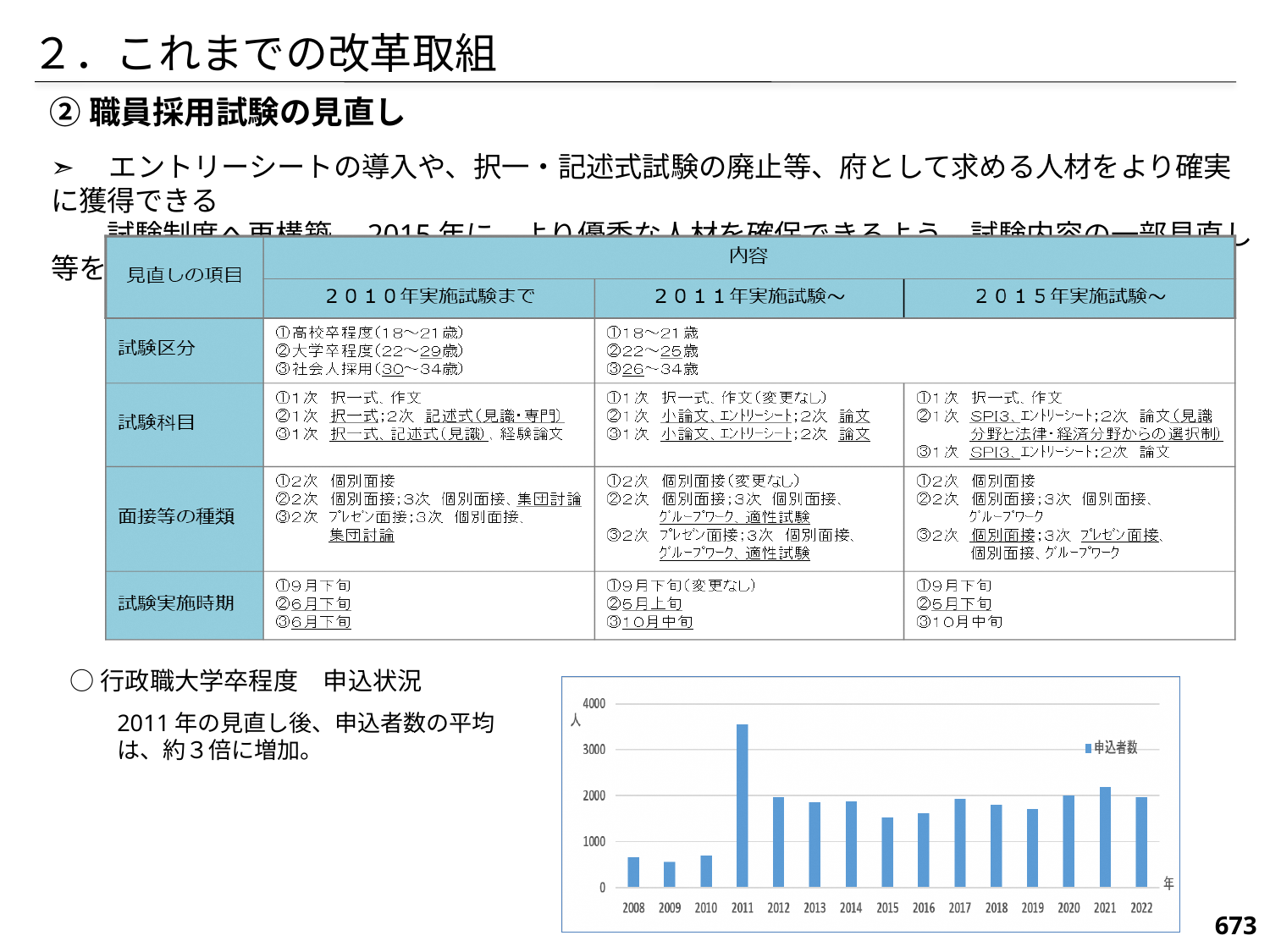
How many years are plotted on the x axis of the bar chart? 15 Is the value for 2011 greater or less than 3000? greater What kind of chart is shown at the bottom right of the slide? bar chart Which year has the larger value, 2010 or 2011? 2011 Is the value for 2015 greater or less than 2000? less Do the values rise or fall from 2008 to 2011 in the bar chart? rise How many series does the legend of the bar chart list? 1 What is the name of the series shown in the legend of the bar chart? 申込者数 Is the value for 2009 greater or less than 1000? less Which year has the lowest value in the bar chart? 2009 Which year has the highest value in the bar chart? 2011